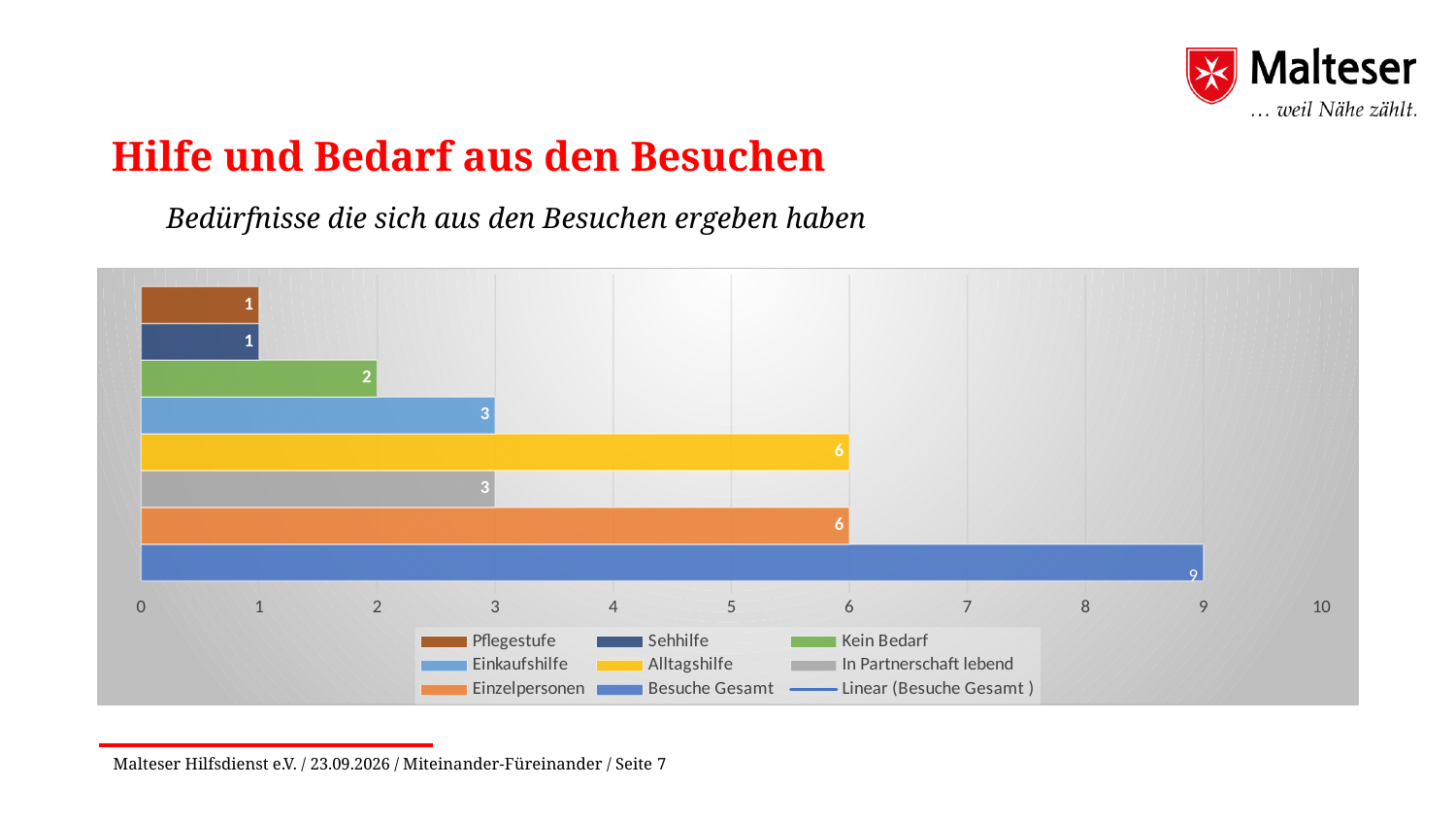
What is the difference between Besuche Gesamt and Einzelpersonen? 3 What is the value for Kein Bedarf? 2 What is the value for Alltagshilfe? 6 Which series has the highest value? Besuche Gesamt What is the value for Besuche Gesamt? 9 What kind of chart is shown on the slide? Bar chart What is the difference between Alltagshilfe and Einkaufshilfe? 3 Which is larger, Kein Bedarf or In Partnerschaft lebend? In Partnerschaft lebend What is the value for Einzelpersonen? 6 How many entries does the legend list? 9 How many bars are plotted in the chart? 8 What is the value for Einkaufshilfe? 3